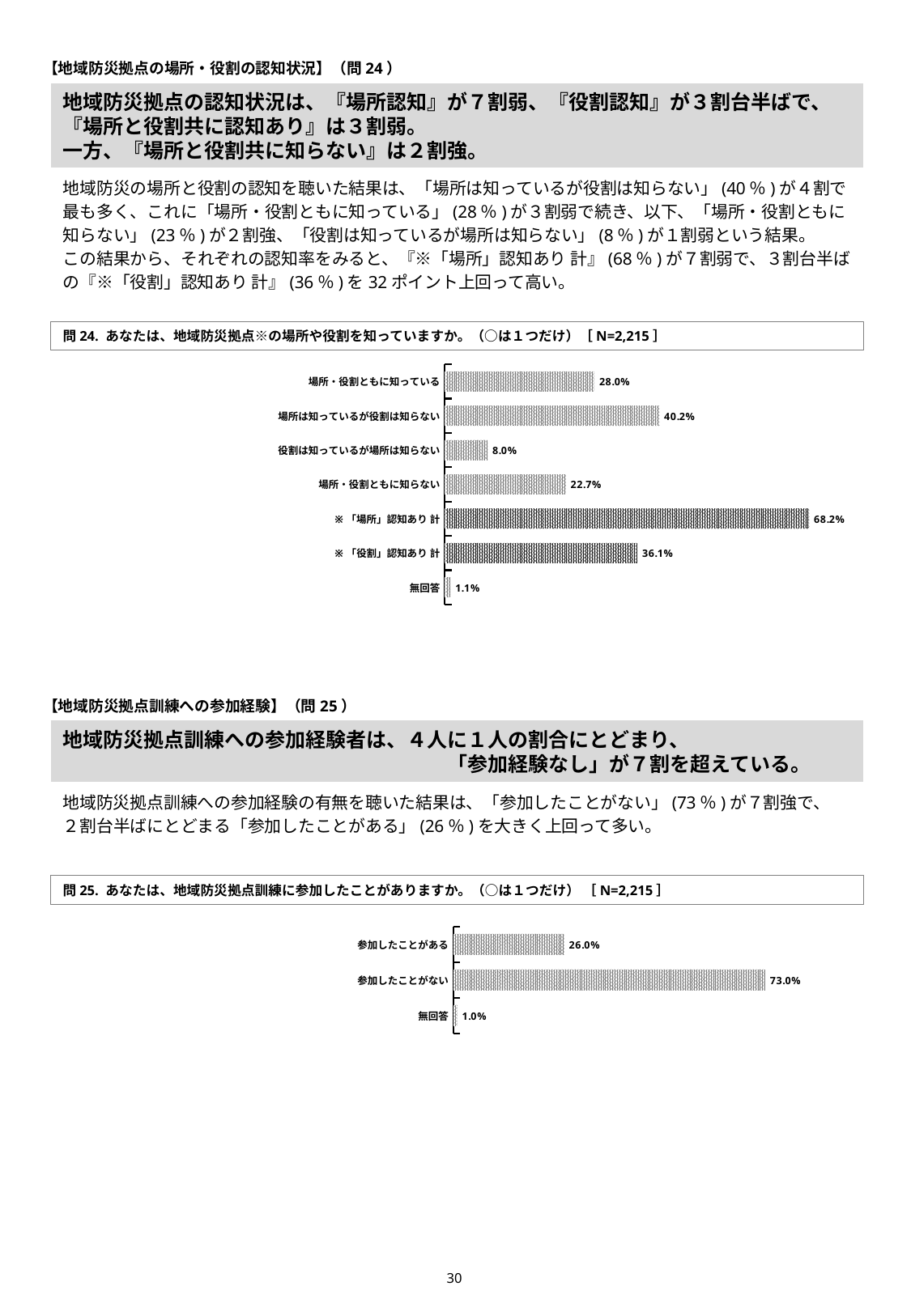
In the 問24 chart, which is larger: 場所・役割ともに知らない or 役割は知っているが場所は知らない? 場所・役割ともに知らない In the 問25 chart, what is the value for 参加したことがある? 26.0% In the 問24 chart, what is the value for ※「場所」認知あり 計? 68.2% In the 問24 chart, which category has the lowest value? 無回答 In the 問24 chart, what is the value for 場所・役割ともに知っている? 28.0% In the 問24 chart, which category has the highest value? ※「場所」認知あり 計 In the 問24 chart, what is the difference between ※「場所」認知あり 計 and ※「役割」認知あり 計? 32.1 percentage points In the 問25 chart, what is the difference between 参加したことがない and 参加したことがある? 47.0 percentage points How many categories are shown in the 問24 chart? 7 What kind of chart is the 問25 chart? Bar chart In the 問24 chart, what is the value for 場所は知っているが役割は知らない? 40.2% In the 問25 chart, what is the value for 参加したことがない? 73.0%